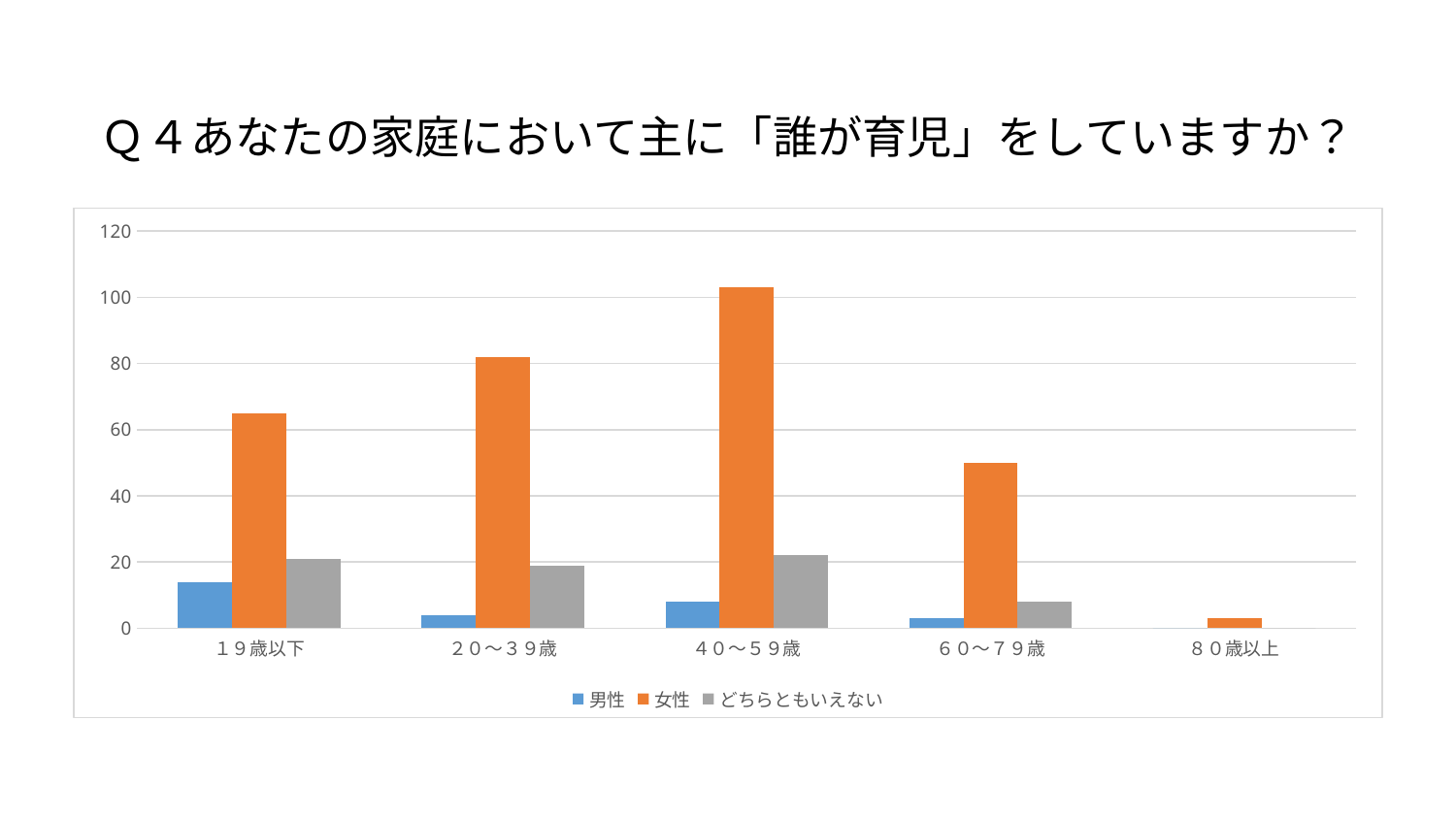
What are the three legend entries of the chart? 男性, 女性, どちらともいえない How many series does the legend list? 3 Is the value for 女性 in the １９歳以下 group greater or less than 60? greater Which age group has the highest value for 女性? ４０〜５９歳 How many age-group categories are shown on the x axis? 5 What kind of chart is shown on the slide? Bar chart Which is larger: the 女性 value for １９歳以下 or for ６０〜７９歳? １９歳以下 In the １９歳以下 group, which is larger: 男性 or どちらともいえない? どちらともいえない Is the value for 男性 in the ２０〜３９歳 group greater or less than 20? less Which age group has the lowest value for 女性? ８０歳以上 Is the value for 女性 in the ６０〜７９歳 group greater or less than 60? less